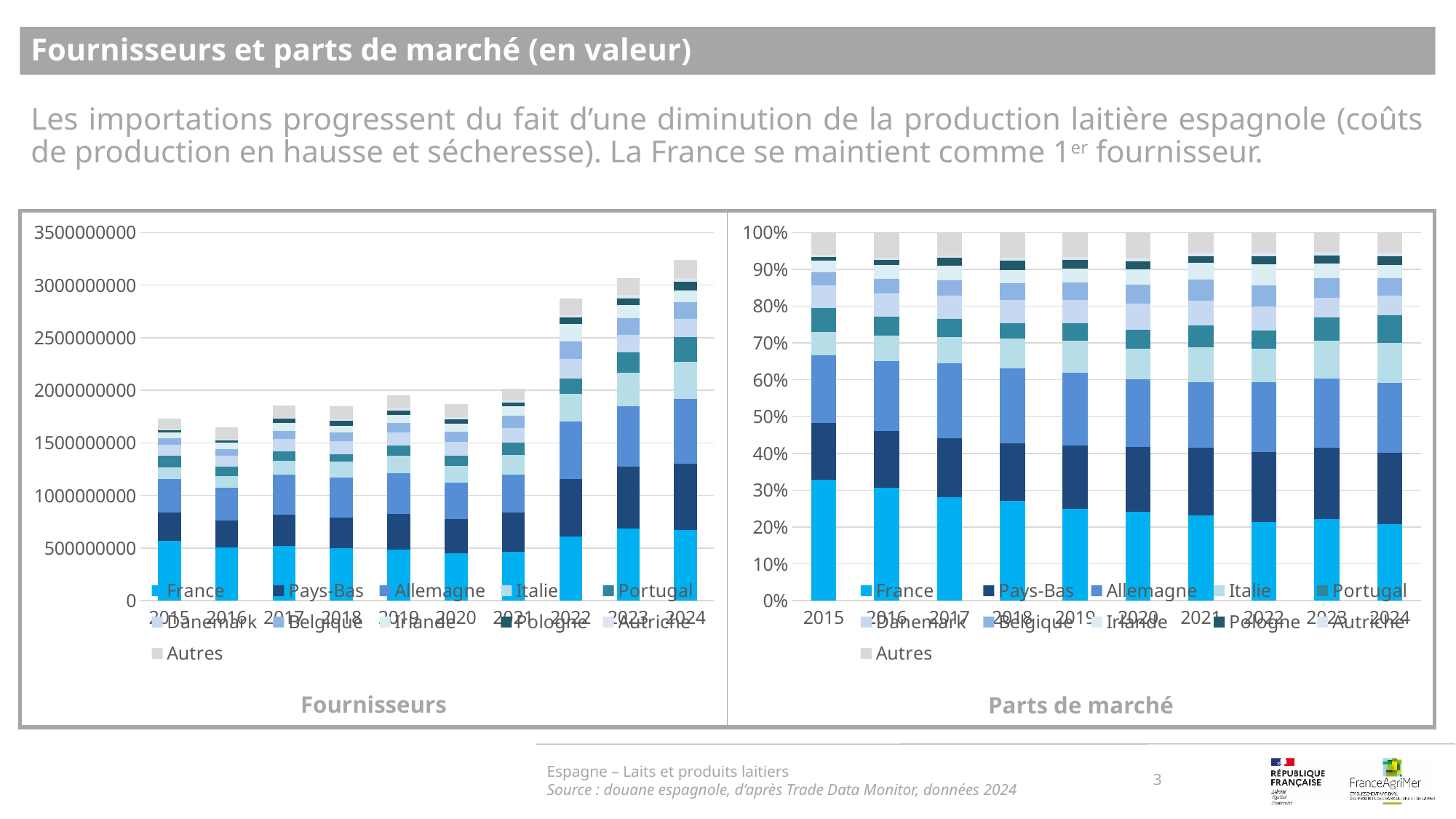
In the 'Parts de marché' chart, is the share for France in 2024 greater or less than 30%? less What kind of chart is the 'Fournisseurs' chart on the left? stacked bar chart In the 'Parts de marché' chart, is the share for France in 2015 greater or less than 30%? greater In the 'Fournisseurs' chart, is the total stacked value for 2024 greater or less than 3000000000? greater In the 'Fournisseurs' chart, which year has the highest total stacked value? 2024 In the 'Fournisseurs' chart, which total is larger, 2021 or 2022? 2022 What is the title shown under the right-hand chart? Parts de marché How many years are shown on the x axis of the 'Parts de marché' chart? 10 Which series is listed first in the legend of the 'Parts de marché' chart? France How many series does the legend of the 'Fournisseurs' chart list? 11 In the 'Parts de marché' chart, does the share for France rise or fall from 2015 to 2024? fall